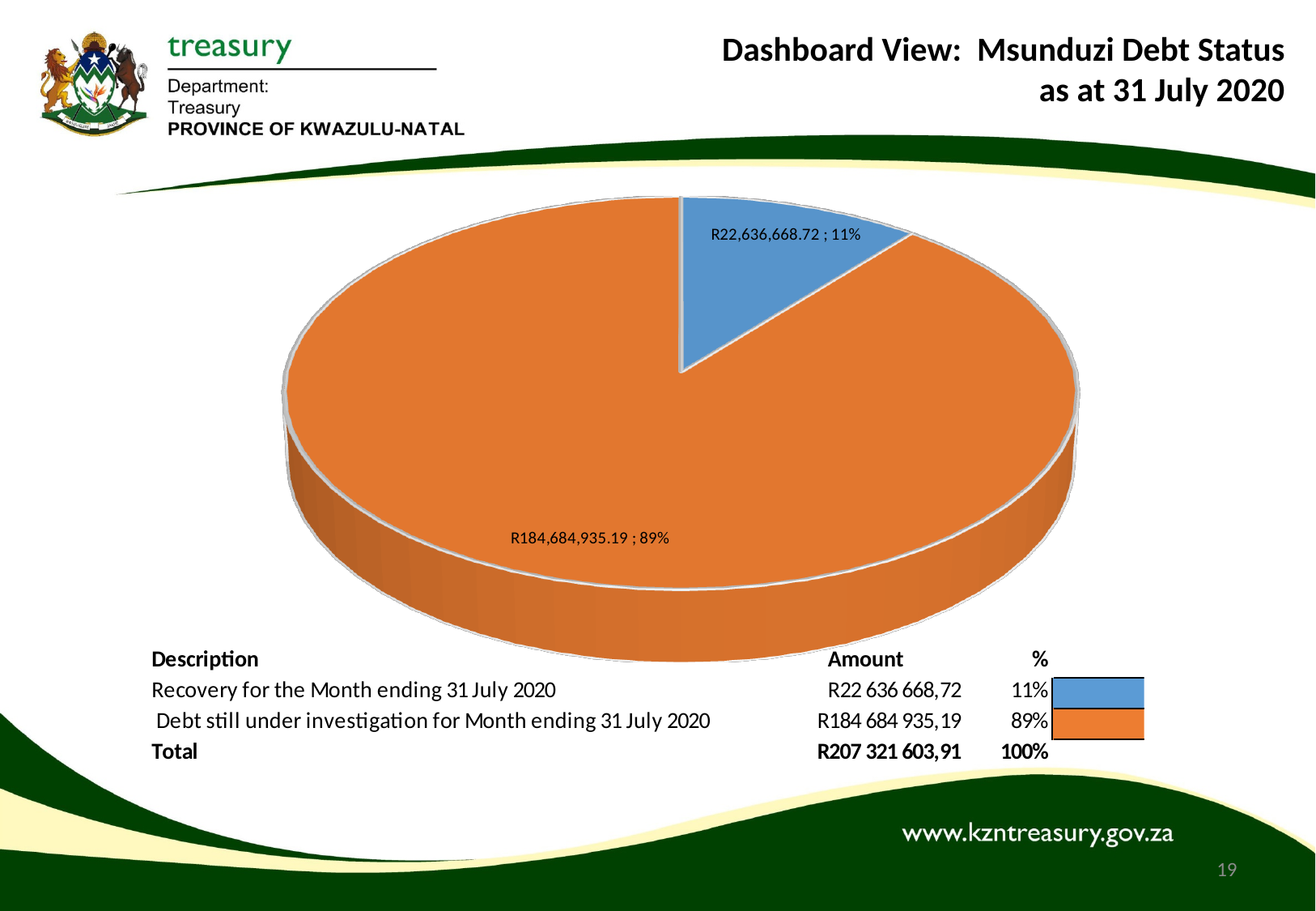
Which slice of the pie chart is the largest? Debt still under investigation for Month ending 31 July 2020 What share of the pie does the Debt still under investigation for Month ending 31 July 2020 slice represent? 89% What is the value of the blue slice (Recovery for the Month ending 31 July 2020) in the pie chart? R22,636,668.72 What kind of chart is shown on the slide? pie chart Which slice of the pie chart is the smallest? Recovery for the Month ending 31 July 2020 What colour is the slice representing Recovery for the Month ending 31 July 2020? blue What is the difference between the Debt still under investigation value and the Recovery value shown in the pie chart? R162,048,266.47 Which is larger: the Recovery slice or the Debt still under investigation slice? Debt still under investigation What share of the pie does the Recovery for the Month ending 31 July 2020 slice represent? 11% What is the value of the orange slice (Debt still under investigation for Month ending 31 July 2020) in the pie chart? R184,684,935.19 How many slices does the pie chart have? 2 What is the total amount shown in the table below the pie chart? R207 321 603,91